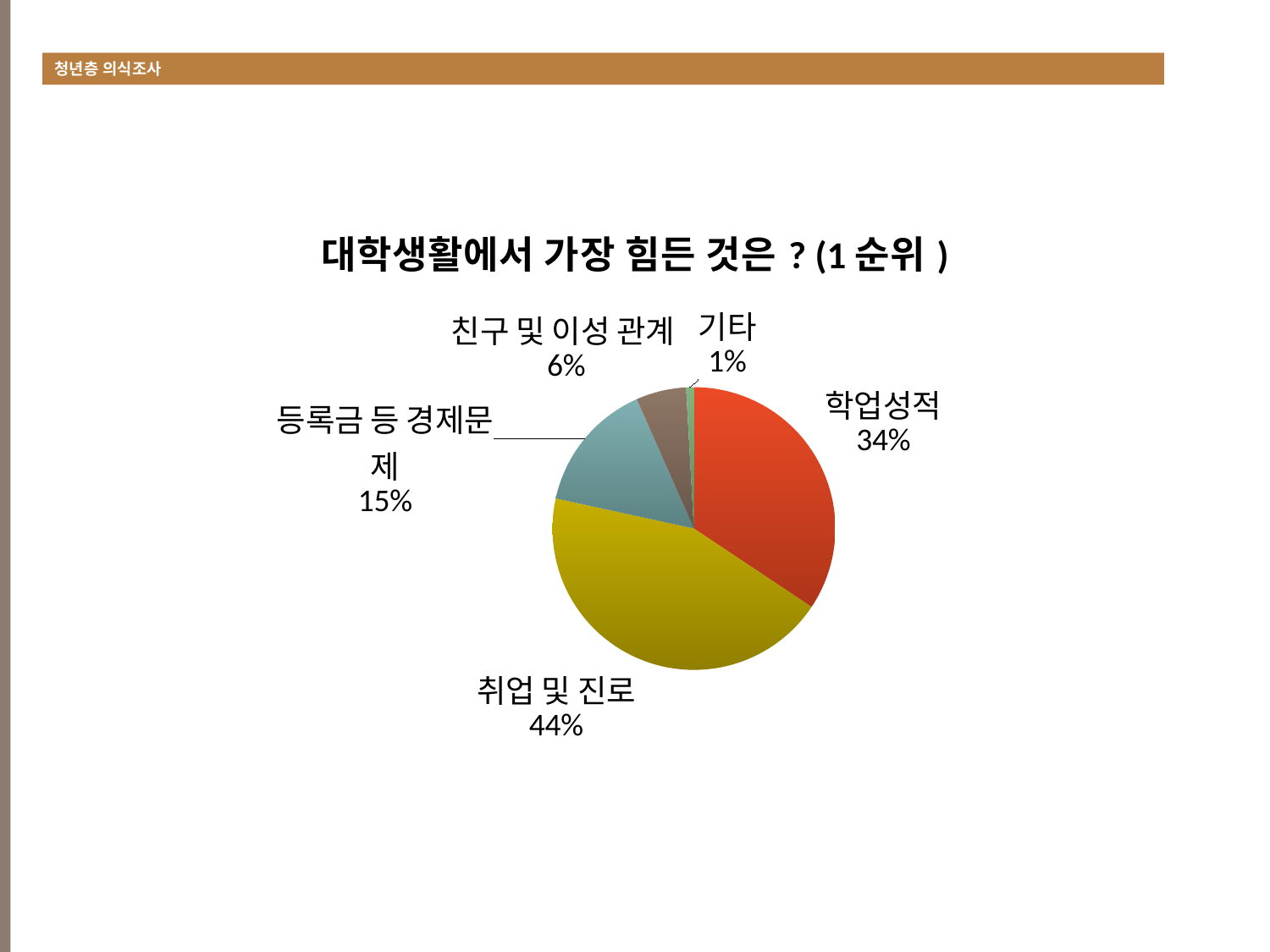
What share of the pie does 취업 및 진로 have? 44% What share of the pie does 기타 have? 1% Which is larger, the share for 등록금 등 경제문제 or the share for 친구 및 이성 관계? 등록금 등 경제문제 What is the title of the chart? 대학생활에서 가장 힘든 것은 ? (1 순위 ) What is the difference in percentage points between 취업 및 진로 and 학업성적? 10 Which category has the largest slice of the pie? 취업 및 진로 What kind of chart is shown on the slide? pie chart How many categories are shown in the pie chart? 5 What share of the pie does 등록금 등 경제문제 have? 15% Which category has the smallest slice of the pie? 기타